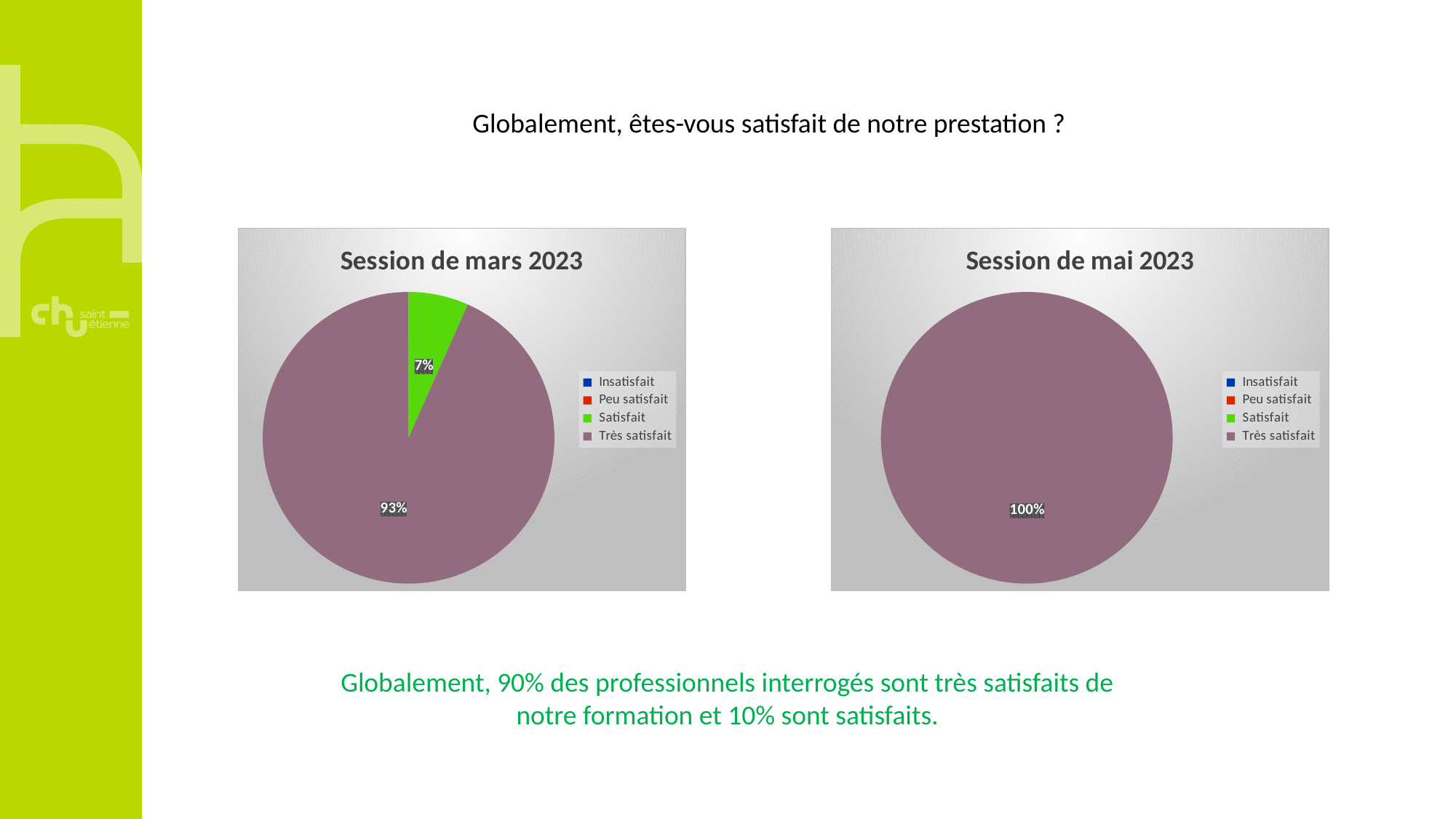
What kind of chart is 'Session de mai 2023'? Pie chart In the 'Session de mai 2023' chart, what share of the pie is 'Très satisfait'? 100% In the 'Session de mars 2023' chart, what share of the pie is 'Satisfait'? 7% What is the title of the chart on the right of the slide? Session de mai 2023 How many entries does the legend of the 'Session de mars 2023' chart list? 4 How many slices are visible in the 'Session de mars 2023' pie? 2 In the 'Session de mars 2023' chart, which is larger, 'Satisfait' or 'Très satisfait'? Très satisfait In the 'Session de mars 2023' chart, what colour is the 'Satisfait' slice? Green In the 'Session de mars 2023' chart, what is the difference between the 'Très satisfait' and 'Satisfait' shares? 86% In the 'Session de mars 2023' chart, what share of the pie is 'Très satisfait'? 93% In the 'Session de mars 2023' chart, which category has the largest slice? Très satisfait How many slices are visible in the 'Session de mai 2023' pie? 1